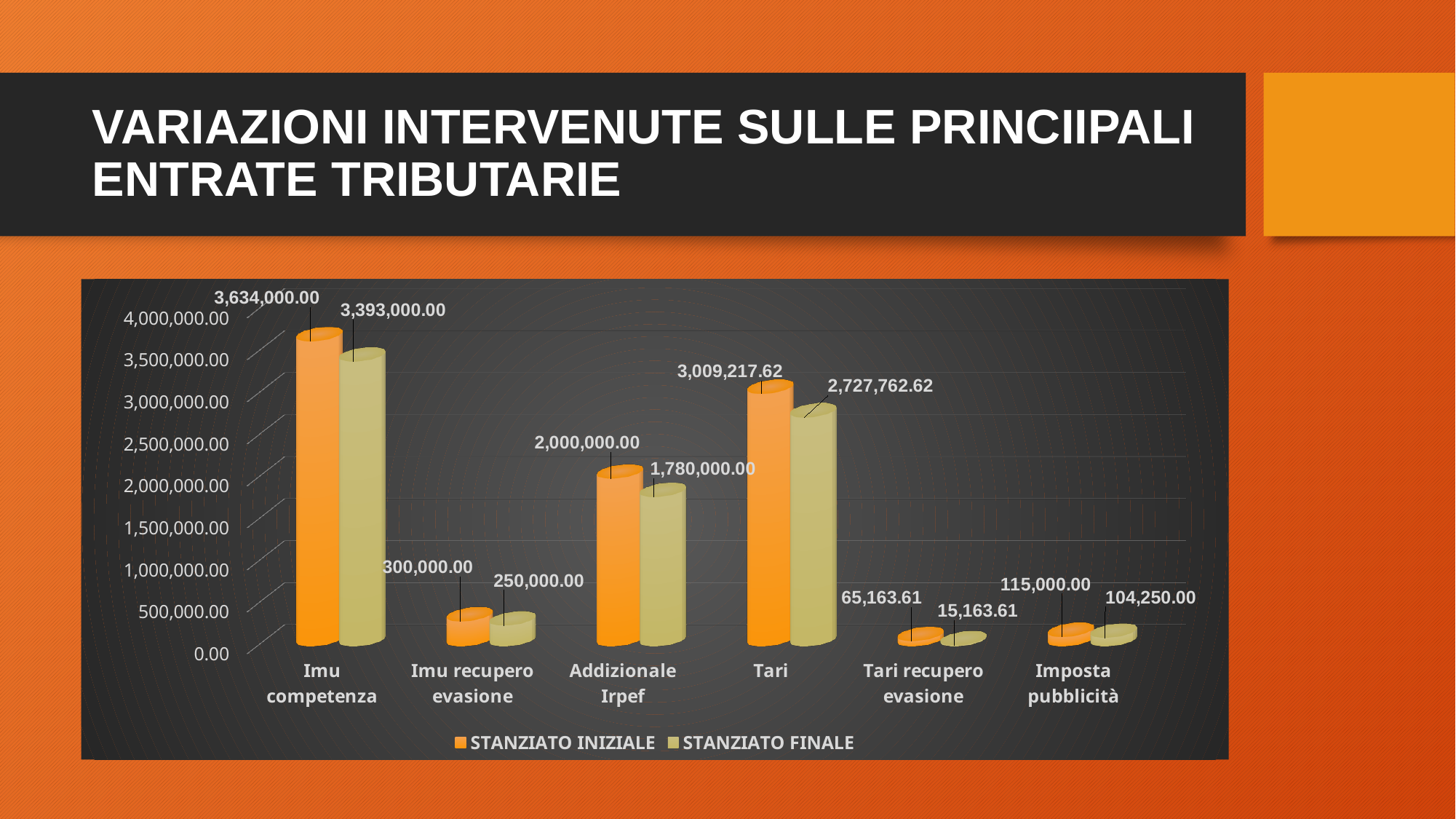
What is the STANZIATO INIZIALE value for Imposta pubblicità? 115,000.00 How many categories are shown on the x axis? 6 What is the STANZIATO INIZIALE value for Imu competenza? 3,634,000.00 What is the STANZIATO FINALE value for Tari? 2,727,762.62 What is the STANZIATO FINALE value for Tari recupero evasione? 15,163.61 How many series does the legend list? 2 Which category has the lowest STANZIATO FINALE value? Tari recupero evasione What is the difference between STANZIATO INIZIALE and STANZIATO FINALE for Addizionale Irpef? 220,000.00 What kind of chart is shown on the slide? Bar chart Which category has the highest STANZIATO INIZIALE value? Imu competenza What is the difference between STANZIATO INIZIALE and STANZIATO FINALE for Tari recupero evasione? 50,000.00 Which is larger: the STANZIATO FINALE value for Imu competenza or the STANZIATO INIZIALE value for Tari? STANZIATO FINALE for Imu competenza